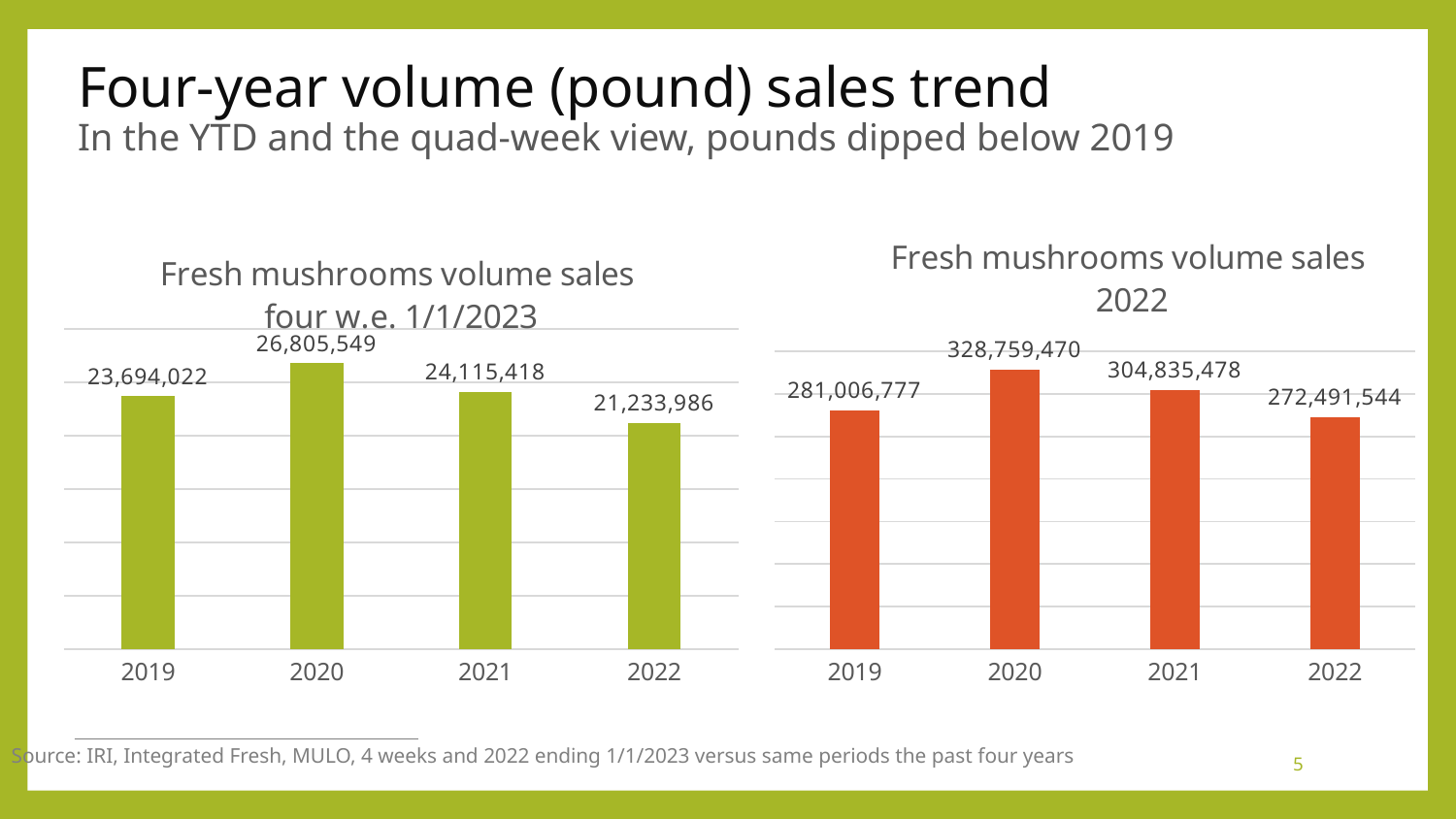
What kind of chart is the 'Fresh mushrooms volume sales four w.e. 1/1/2023' chart? Bar chart How many years are shown on the x axis of the 'Fresh mushrooms volume sales 2022' chart? 4 In the 'Fresh mushrooms volume sales four w.e. 1/1/2023' chart, which is larger, the value for 2021 or the value for 2019? 2021 In the 'Fresh mushrooms volume sales four w.e. 1/1/2023' chart, which year has the lowest value? 2022 In the 'Fresh mushrooms volume sales 2022' chart, which year has the highest value? 2020 In the 'Fresh mushrooms volume sales 2022' chart, which is larger, the value for 2019 or the value for 2022? 2019 What colour are the bars in the 'Fresh mushrooms volume sales 2022' chart? Orange In the 'Fresh mushrooms volume sales 2022' chart, do the values rise or fall from 2020 to 2022? Fall In the 'Fresh mushrooms volume sales four w.e. 1/1/2023' chart, what is the difference between the 2020 and 2022 values? 5,571,563 In the 'Fresh mushrooms volume sales 2022' chart, what is the difference between the 2020 and 2019 values? 47,752,693 In the 'Fresh mushrooms volume sales four w.e. 1/1/2023' chart, what is the value for 2020? 26,805,549 In the 'Fresh mushrooms volume sales 2022' chart, what is the value for 2021? 304,835,478